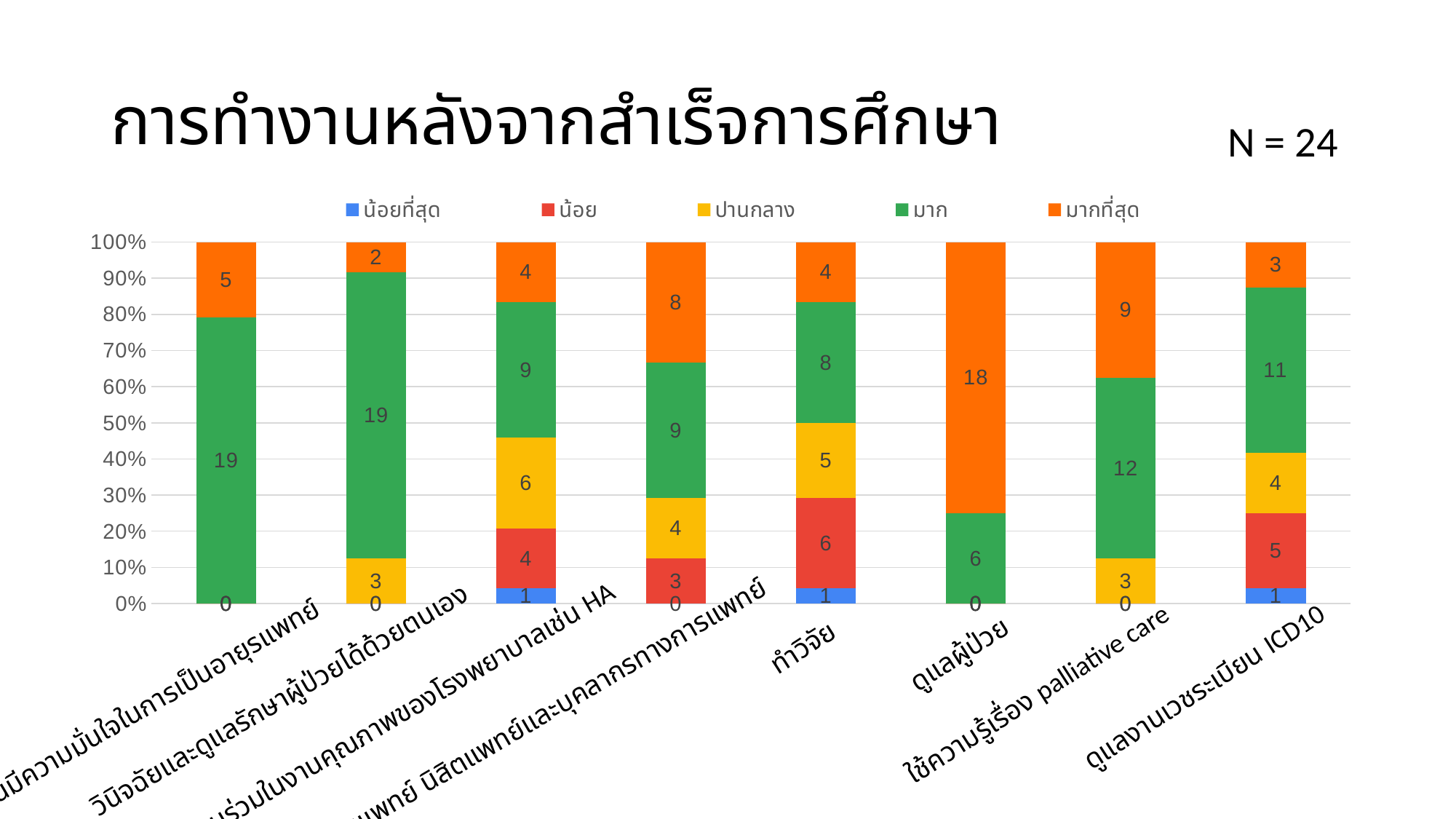
How many series does the legend list? 5 What is the value of the น้อย series for ทำวิจัย? 6 How many categories (bars) are plotted on the chart? 8 Which category has the highest value for the มากที่สุด series? ดูแลผู้ป่วย Which is larger: the มาก value for ทำวิจัย or the มาก value for ดูแลงานเวชระเบียน ICD10? ดูแลงานเวชระเบียน ICD10 Is the มากที่สุด share of the ดูแลผู้ป่วย bar greater or less than 70%? greater Which legend entry is shown in orange? มากที่สุด What kind of chart is shown on the slide? stacked bar chart What is the value of the มากที่สุด series for ดูแลผู้ป่วย? 18 What is the value of the มาก series for ใช้ความรู้เรื่อง palliative care? 12 What is the value of the ปานกลาง series for ดูแลงานเวชระเบียน ICD10? 4 What is the difference between the มากที่สุด values for ดูแลผู้ป่วย and ใช้ความรู้เรื่อง palliative care? 9